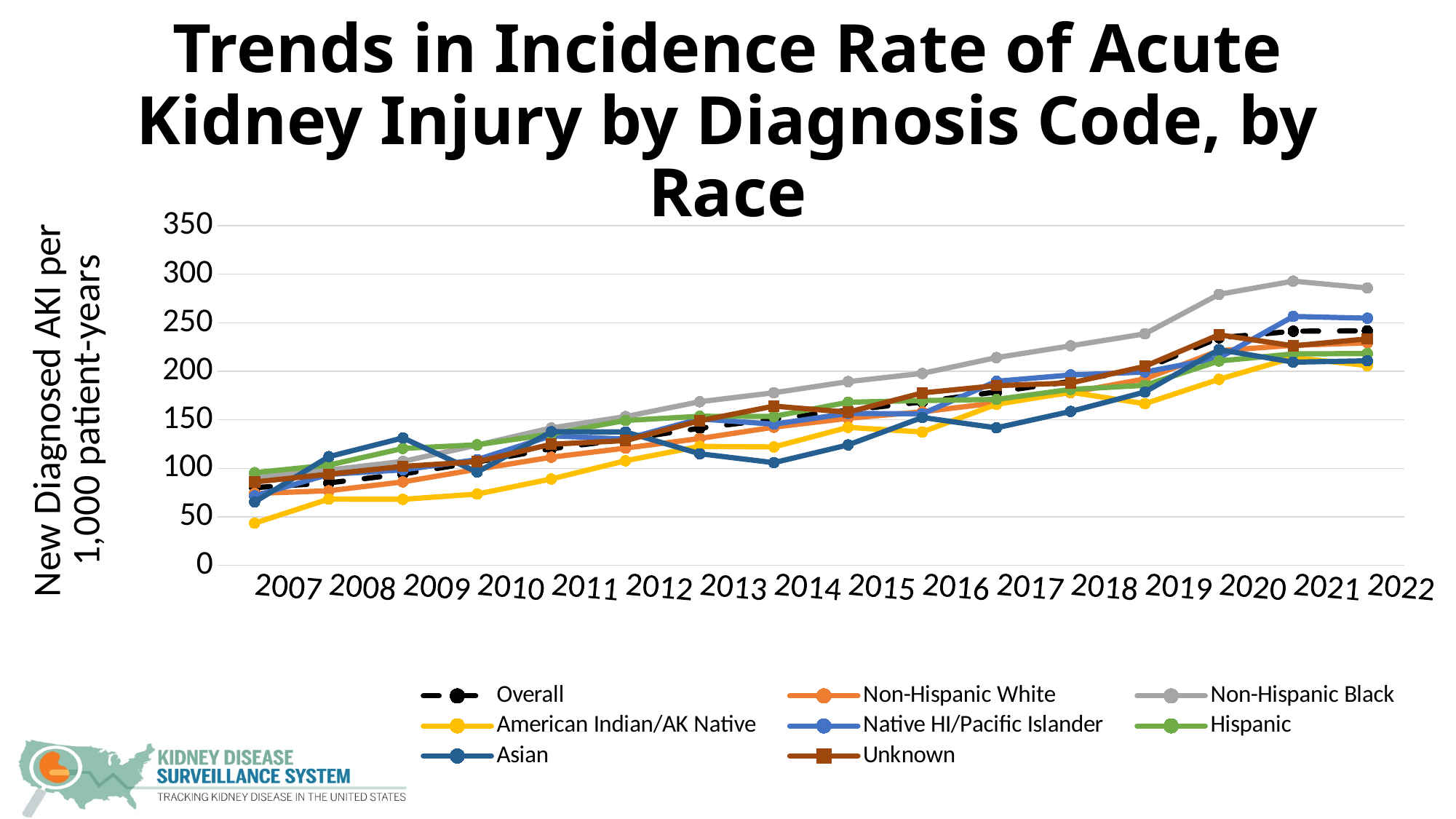
Is the value for Non-Hispanic Black in 2021 greater or less than 250? greater Is the value for American Indian/AK Native in 2007 greater or less than 50? less Is the value for Overall in 2007 greater or less than 100? less What is the label on the y axis? New Diagnosed AKI per 1,000 patient-years Does the Overall incidence rate generally rise or fall from 2007 to 2022? Rise What type of chart is shown on the slide? Line chart In 2014, which is larger: the value for Asian or the value for Non-Hispanic Black? Non-Hispanic Black Which race group has the highest incidence rate in 2022? Non-Hispanic Black How many series does the legend list? 8 What is the title of the chart? Trends in Incidence Rate of Acute Kidney Injury by Diagnosis Code, by Race How many years are plotted along the x axis? 16 Which race group has the lowest incidence rate in 2007? American Indian/AK Native